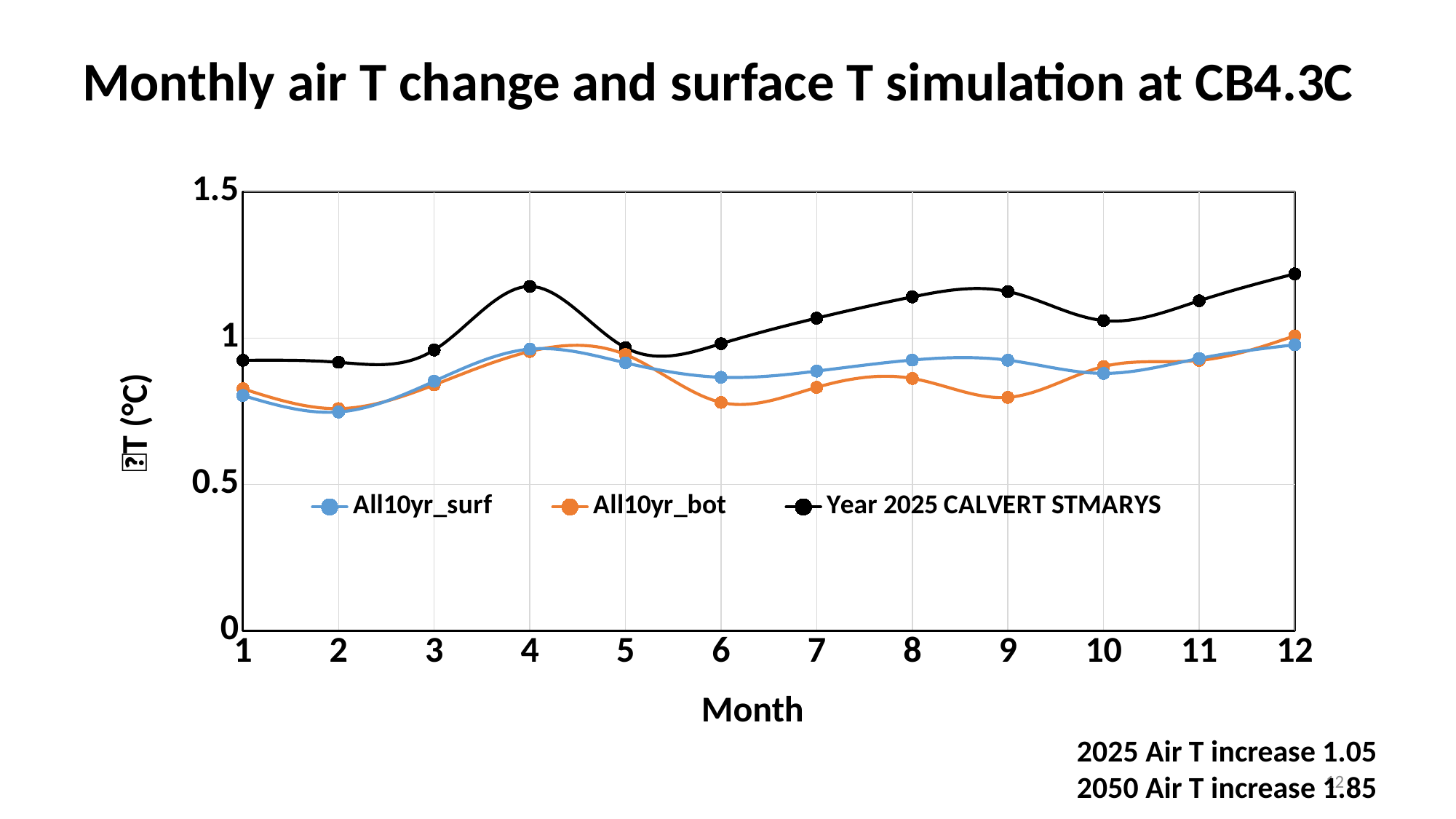
At month 4, which series has the larger value: Year 2025 CALVERT STMARYS or All10yr_surf? Year 2025 CALVERT STMARYS Is the value for Year 2025 CALVERT STMARYS at month 12 greater or less than 1? greater What kind of chart is shown on the slide? line chart Is the value for All10yr_surf at month 2 greater or less than 1? less At month 9, which series has the larger value: All10yr_surf or All10yr_bot? All10yr_surf Is the value for All10yr_bot at month 6 greater or less than 1? less Does the Year 2025 CALVERT STMARYS series generally rise or fall from month 1 to month 12? rise In which month is the All10yr_surf series at its lowest? 2 How many months are plotted along the x axis? 12 How many series does the legend list? 3 What is the title of the x axis? Month